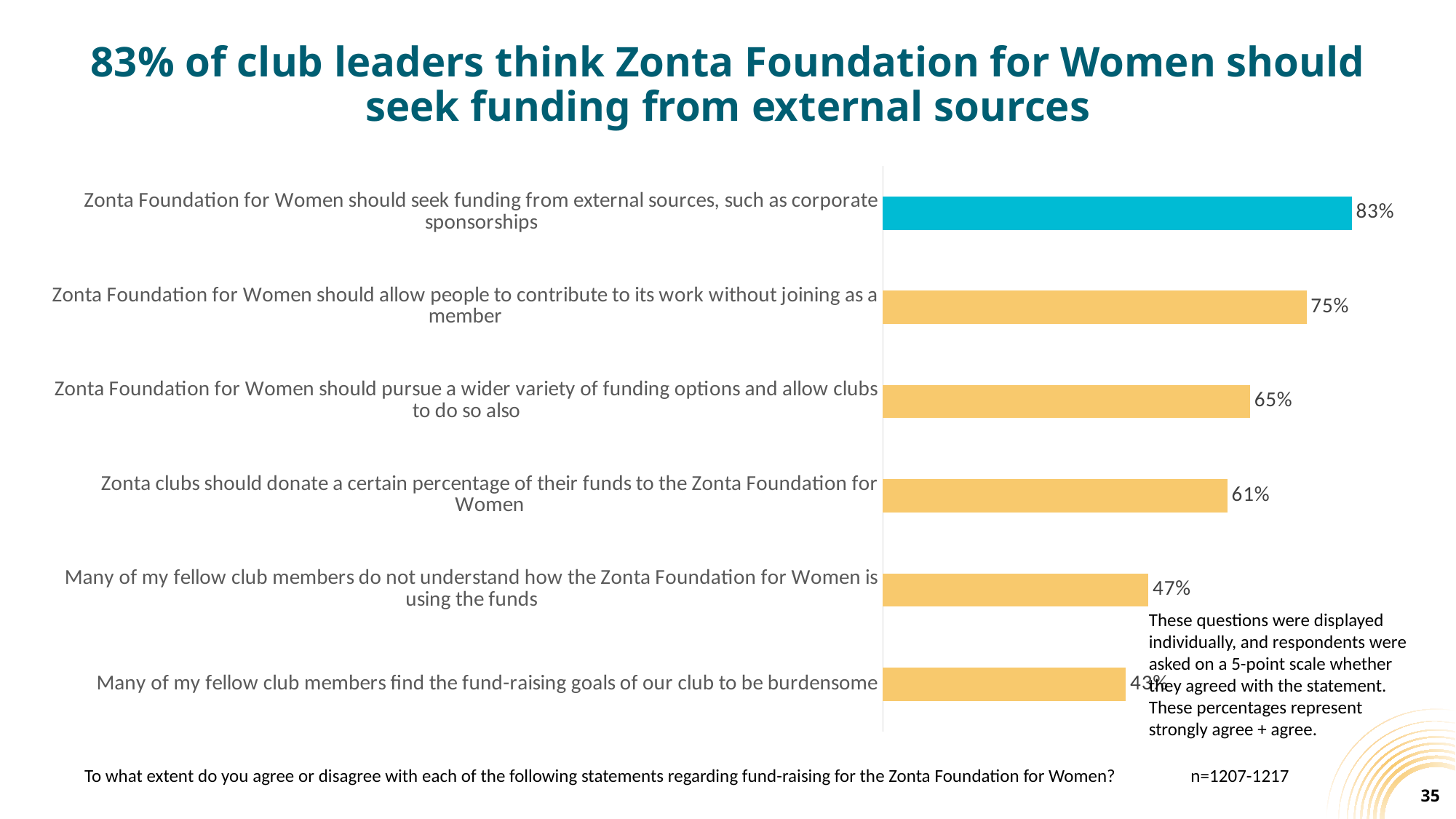
Which statement has the lowest level of agreement? Many of my fellow club members find the fund-raising goals of our club to be burdensome Which statement has the highest level of agreement? Zonta Foundation for Women should seek funding from external sources, such as corporate sponsorships What percentage agree that Zonta clubs should donate a certain percentage of their funds to the Zonta Foundation for Women? 61% What is the difference between the agreement for seeking funding from external sources and allowing people to contribute without joining as a member? 8% What percentage of club leaders agree that Zonta Foundation for Women should seek funding from external sources, such as corporate sponsorships? 83% What is the value for the statement that Zonta Foundation for Women should pursue a wider variety of funding options and allow clubs to do so also? 65% How many statements are shown in the chart? 6 What percentage agree that Zonta Foundation for Women should allow people to contribute to its work without joining as a member? 75% Which has a higher value: the statement that club members do not understand how the funds are used, or the statement that club members find fund-raising goals burdensome? Many of my fellow club members do not understand how the Zonta Foundation for Women is using the funds What percentage agree that many of their fellow club members do not understand how the Zonta Foundation for Women is using the funds? 47% What is the difference between the agreement for pursuing a wider variety of funding options and the agreement that clubs should donate a certain percentage of their funds? 4% What type of chart is shown on the slide? Bar chart